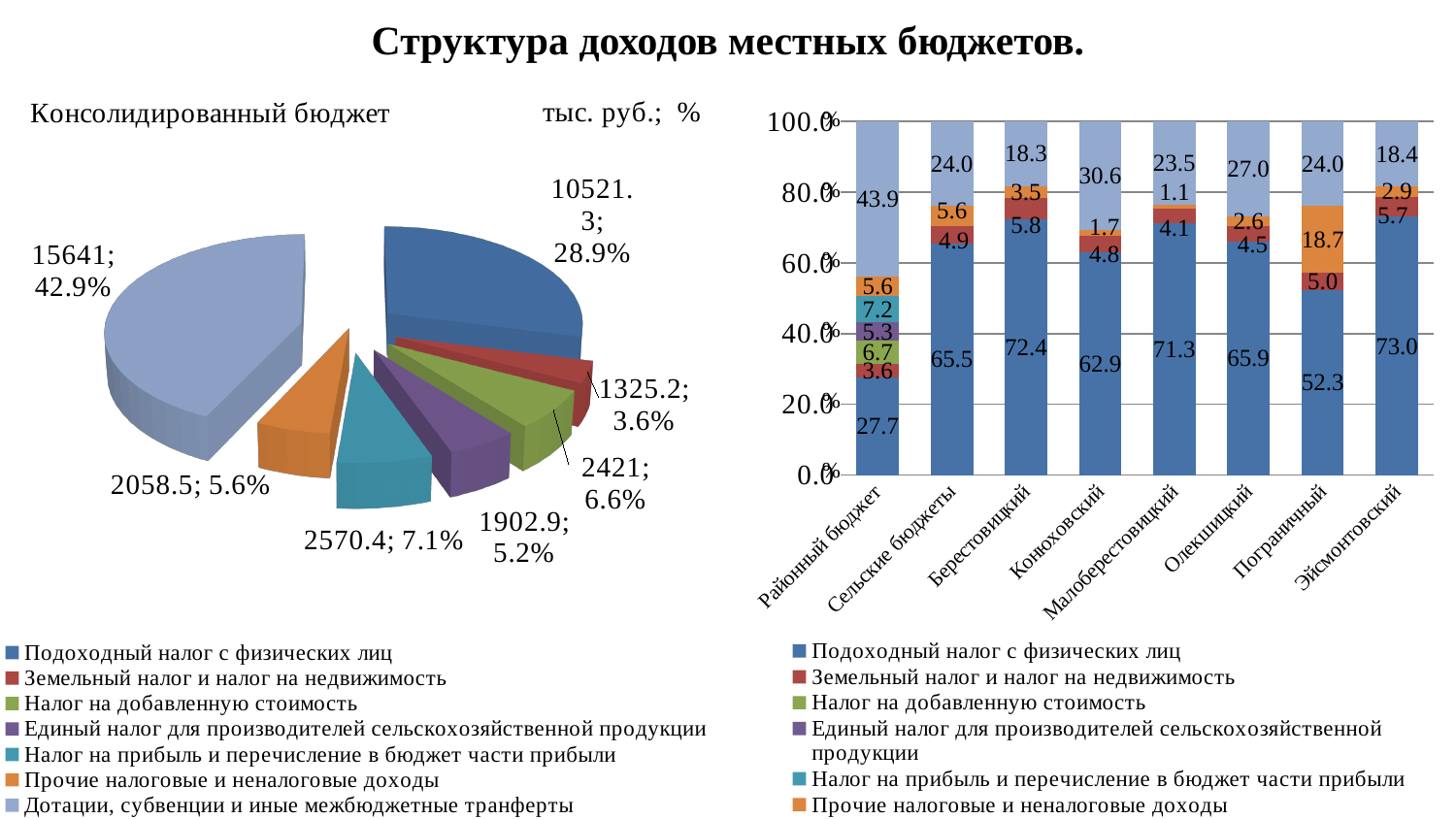
In the stacked bar chart on the right, which category has the highest value for Подоходный налог с физических лиц? Эйсмонтовский In the Консолидированный бюджет pie chart, which slice is the smallest? Земельный налог и налог на недвижимость What kind of chart is the chart on the right? Stacked bar chart What kind of chart is the Консолидированный бюджет chart on the left? Pie chart In the Консолидированный бюджет pie chart, what is the value for Подоходный налог с физических лиц? 10521.3 In the stacked bar chart on the right, which is larger: the Прочие налоговые и неналоговые доходы value for Пограничный or for Олекшицкий? Пограничный In the stacked bar chart on the right, which category has the lowest value for Подоходный налог с физических лиц? Районный бюджет In the stacked bar chart on the right, what is the difference between the Подоходный налог с физических лиц values for Эйсмонтовский and Пограничный? 20.7 In the Консолидированный бюджет pie chart, what share does Дотации, субвенции и иные межбюджетные трансферты have? 42.9% How many series does the legend of the chart on the right list? 6 How many categories are shown on the x axis of the stacked bar chart on the right? 8 In the stacked bar chart on the right, what is the value of Подоходный налог с физических лиц for Эйсмонтовский? 73.0